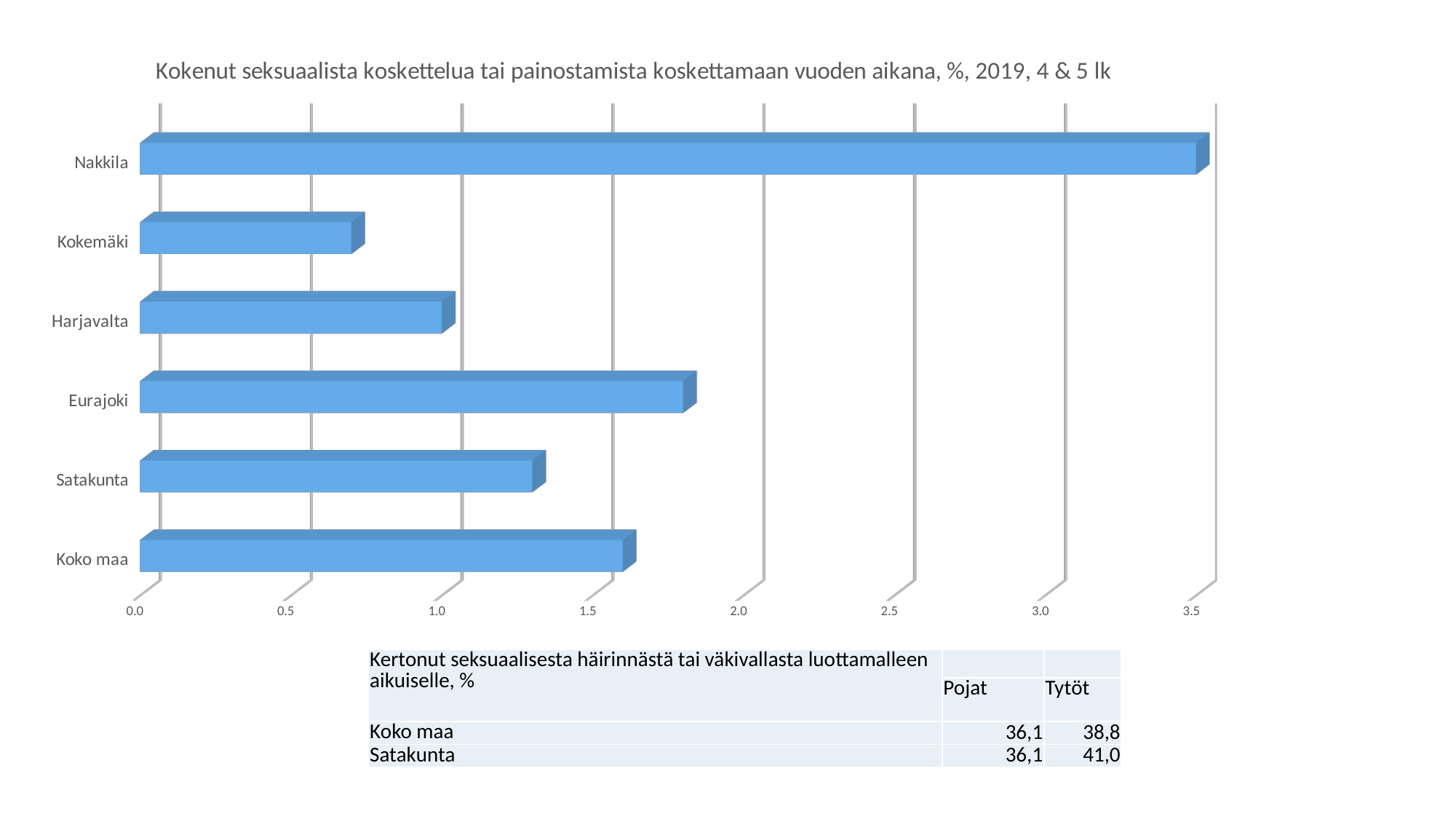
Which category has the lowest value in the chart? Kokemäki Is the value for Koko maa greater or less than 1.0? greater Is the value for Nakkila greater or less than 3.0? greater Is the value for Kokemäki greater or less than 1.0? less What is the title of the chart? Kokenut seksuaalista koskettelua tai painostamista koskettamaan vuoden aikana, %, 2019, 4 & 5 lk What kind of chart is shown on the slide? bar chart Which has a larger value, Koko maa or Harjavalta? Koko maa Which category has the highest value in the chart? Nakkila How many categories are plotted in the bar chart? 6 Which has a larger value, Eurajoki or Satakunta? Eurajoki